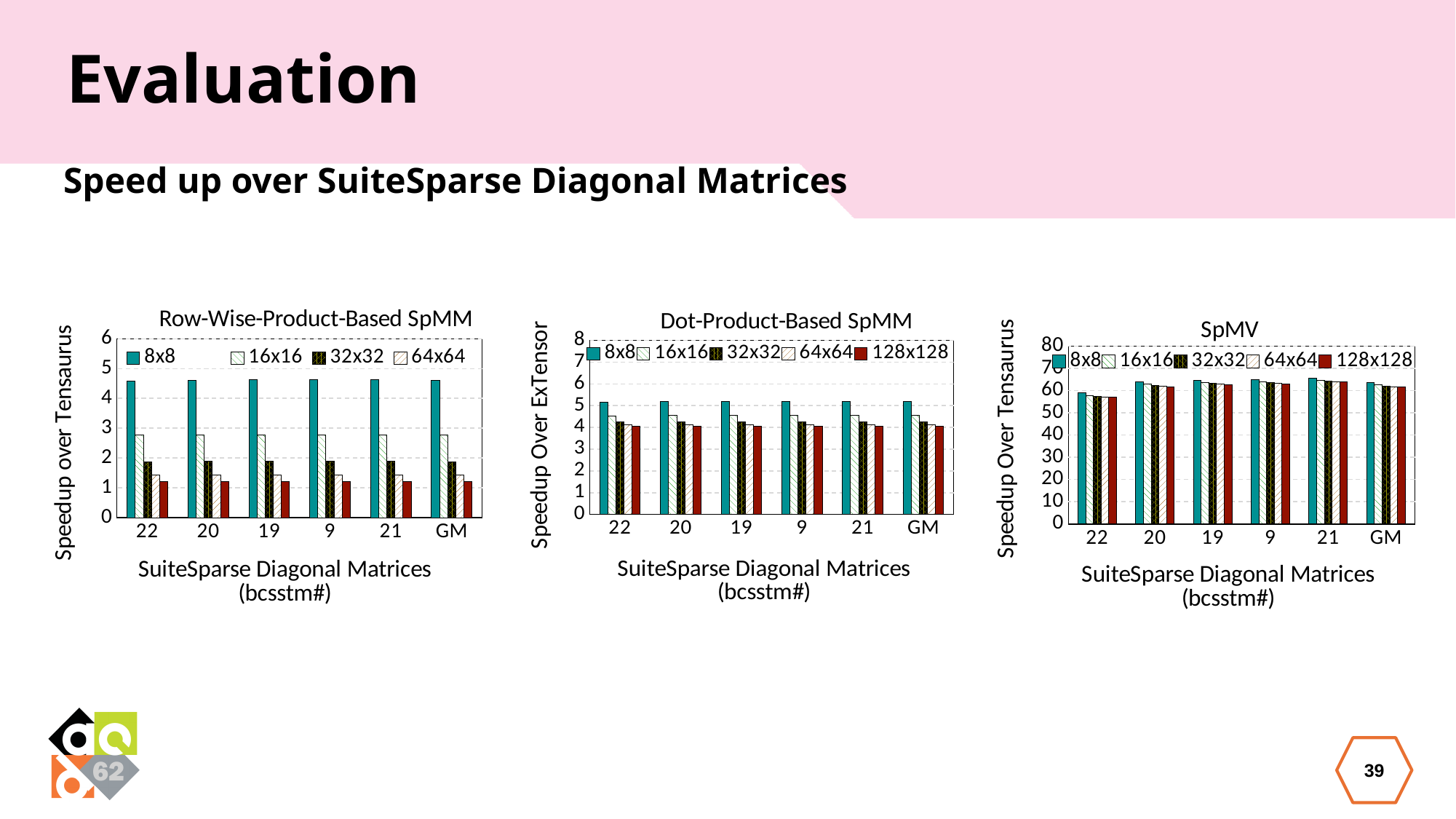
In the Row-Wise-Product-Based SpMM chart, how many matrix categories are shown on the x axis? 6 In the SpMV chart, is the 8x8 value for matrix 22 greater or less than 50? greater In the SpMV chart, is the 128x128 value for matrix 21 greater or less than 60? greater In the Row-Wise-Product-Based SpMM chart, which series has the highest value for matrix 22? 8x8 In the Row-Wise-Product-Based SpMM chart, is the 8x8 value for matrix 22 greater or less than 4? greater What is the y-axis title of the Dot-Product-Based SpMM chart? Speedup Over ExTensor In the Dot-Product-Based SpMM chart, how many series does the legend list? 5 What kind of chart is the Row-Wise-Product-Based SpMM chart? bar chart In the SpMV chart, how many series does the legend list? 5 In the Dot-Product-Based SpMM chart, which is larger for GM: the 8x8 value or the 128x128 value? 8x8